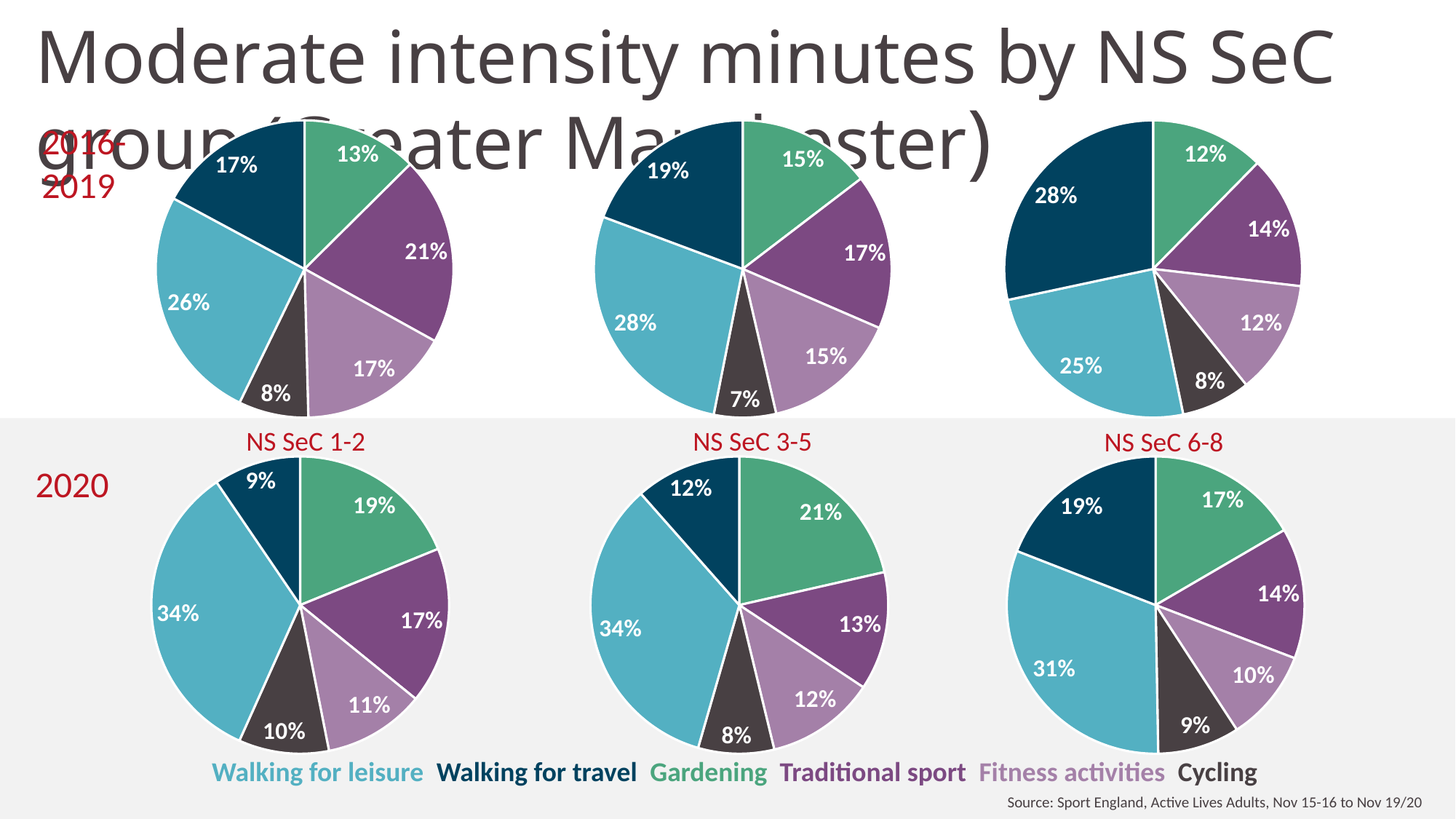
In the 2020 NS SeC 6-8 pie chart, which activity has the largest share? Walking for leisure In the 2016-2019 NS SeC 6-8 pie chart, what share is Walking for travel? 28% In the 2020 NS SeC 3-5 pie chart, what share is Gardening? 21% In the 2016-2019 NS SeC 6-8 pie chart, which is larger: Walking for travel or Walking for leisure? Walking for travel How many activities does the legend list? 6 In the 2016-2019 NS SeC 3-5 pie chart, what share is Cycling? 7% In the 2020 NS SeC 1-2 pie chart, what share is Walking for leisure? 34% In the 2020 NS SeC 1-2 pie chart, what is the difference between the Walking for leisure share and the Walking for travel share? 25% How many slices does each pie chart on the slide have? 6 In the 2016-2019 NS SeC 1-2 pie chart, which activity has the smallest share? Cycling Which colour represents Gardening in the legend? Green What kind of charts are shown on the slide? Pie charts